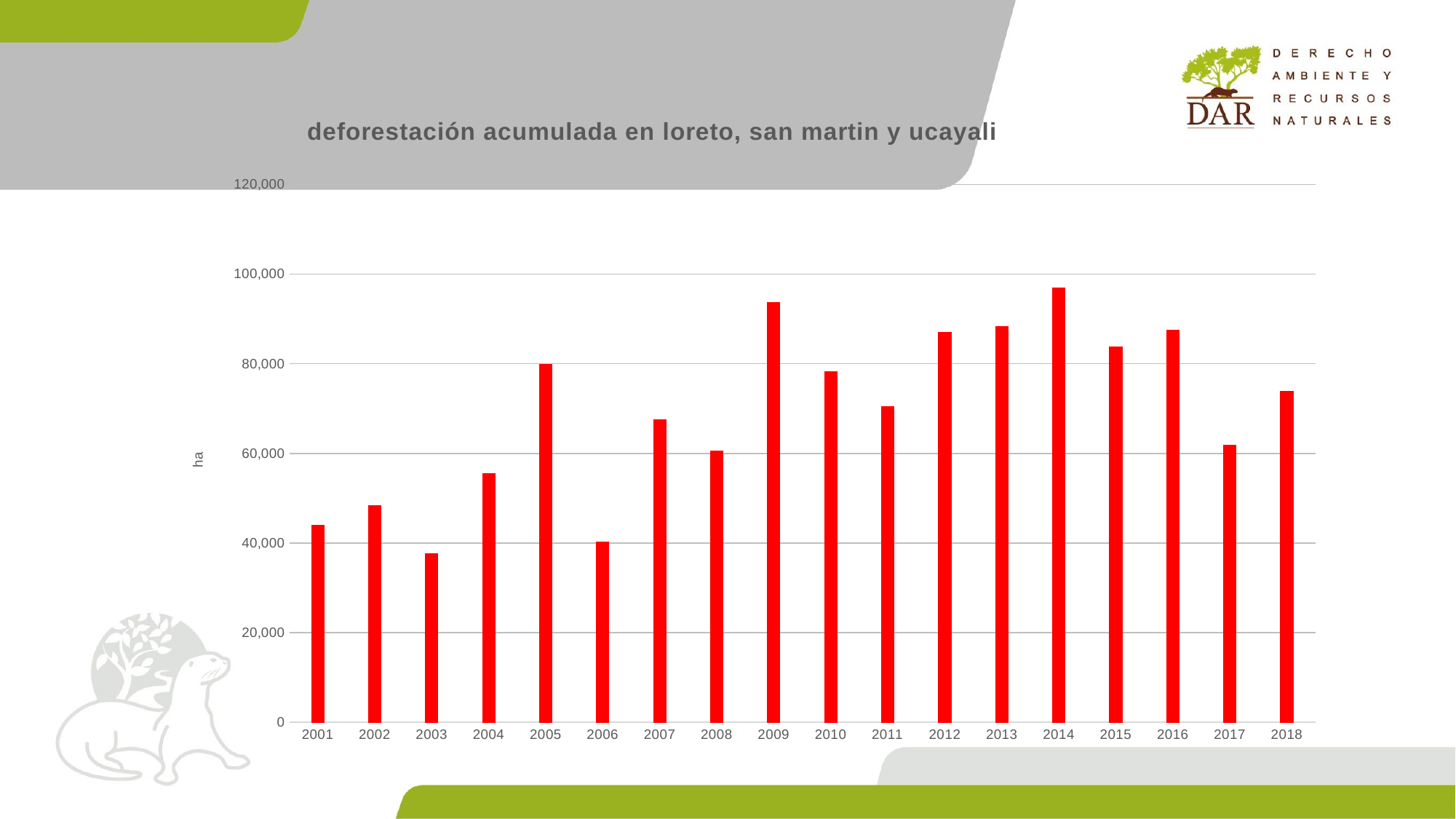
Which year has the lowest bar in the chart? 2003 Is the value for 2011 greater or less than 60,000? greater Which year has the larger value, 2004 or 2005? 2005 How many years are plotted on the x axis of the chart? 18 What kind of chart is shown on the slide? bar chart Is the value for 2009 greater or less than 80,000? greater Which year has the larger value, 2009 or 2010? 2009 Is the value for 2003 greater or less than 40,000? less What is the title of the chart? deforestación acumulada en loreto, san martin y ucayali What unit is shown on the vertical axis of the chart? ha Which year has the highest bar in the chart? 2014